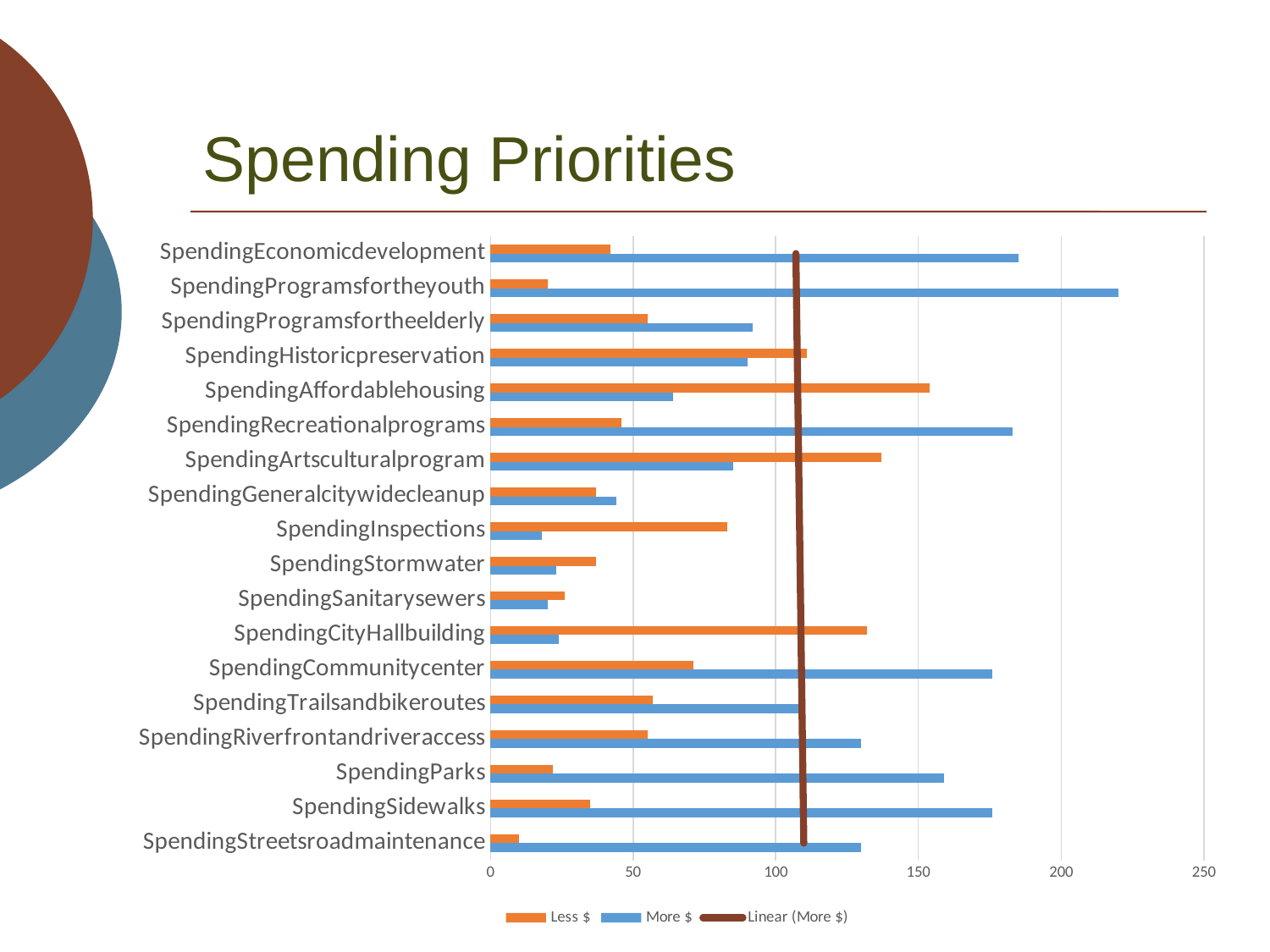
Which category has the highest Less $ value? SpendingAffordablehousing Which is larger for SpendingParks, the Less $ value or the More $ value? More $ What is the title of the slide containing the chart? Spending Priorities Which category has the highest More $ value? SpendingProgramsfortheyouth Is the More $ value for SpendingEconomicdevelopment greater or less than 150? greater Which is larger for SpendingArtsculturalprogram, the Less $ value or the More $ value? Less $ Which category has the lowest Less $ value? SpendingStreetsroadmaintenance Is the Less $ value for SpendingInspections greater or less than 100? less What kind of chart is shown on the slide? bar chart Is the More $ value for SpendingCityHallbuilding greater or less than 50? less How many entries does the chart legend list? 3 How many spending categories are plotted on the chart? 18